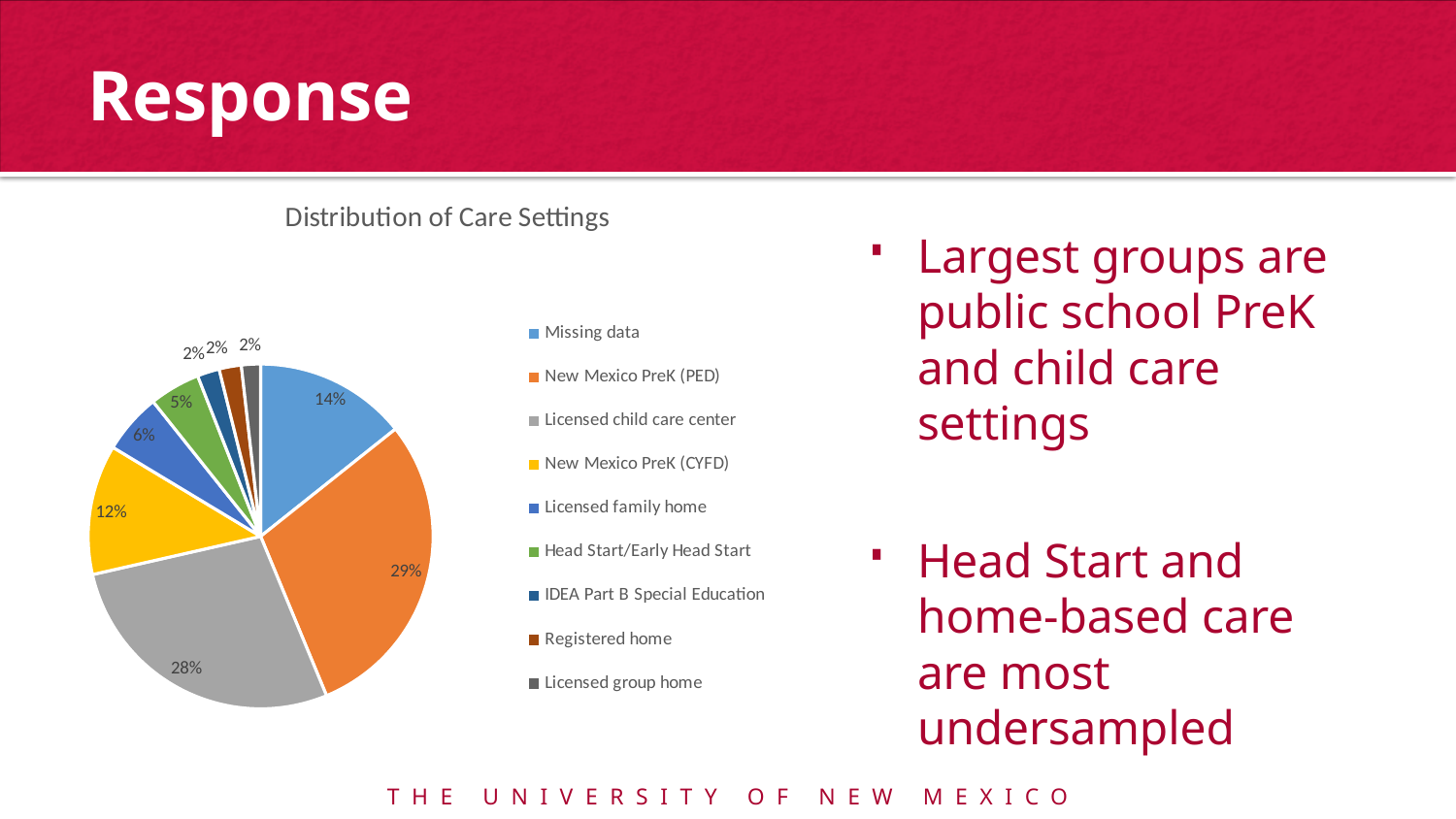
What share of the pie is New Mexico PreK (CYFD)? 12% How many categories does the legend list? 9 What is the difference in percentage points between New Mexico PreK (PED) and New Mexico PreK (CYFD)? 17 Which category has the largest share of the pie? New Mexico PreK (PED) Which is larger, the share for Licensed family home or the share for Head Start/Early Head Start? Licensed family home What is the title of the chart? Distribution of Care Settings What percentage is labelled Missing data? 14% What percentage does Licensed family home account for? 6% What percentage does Head Start/Early Head Start account for? 5% What kind of chart is shown on the slide? pie chart What share of the pie is Licensed child care center? 28% What share of the pie is New Mexico PreK (PED)? 29%